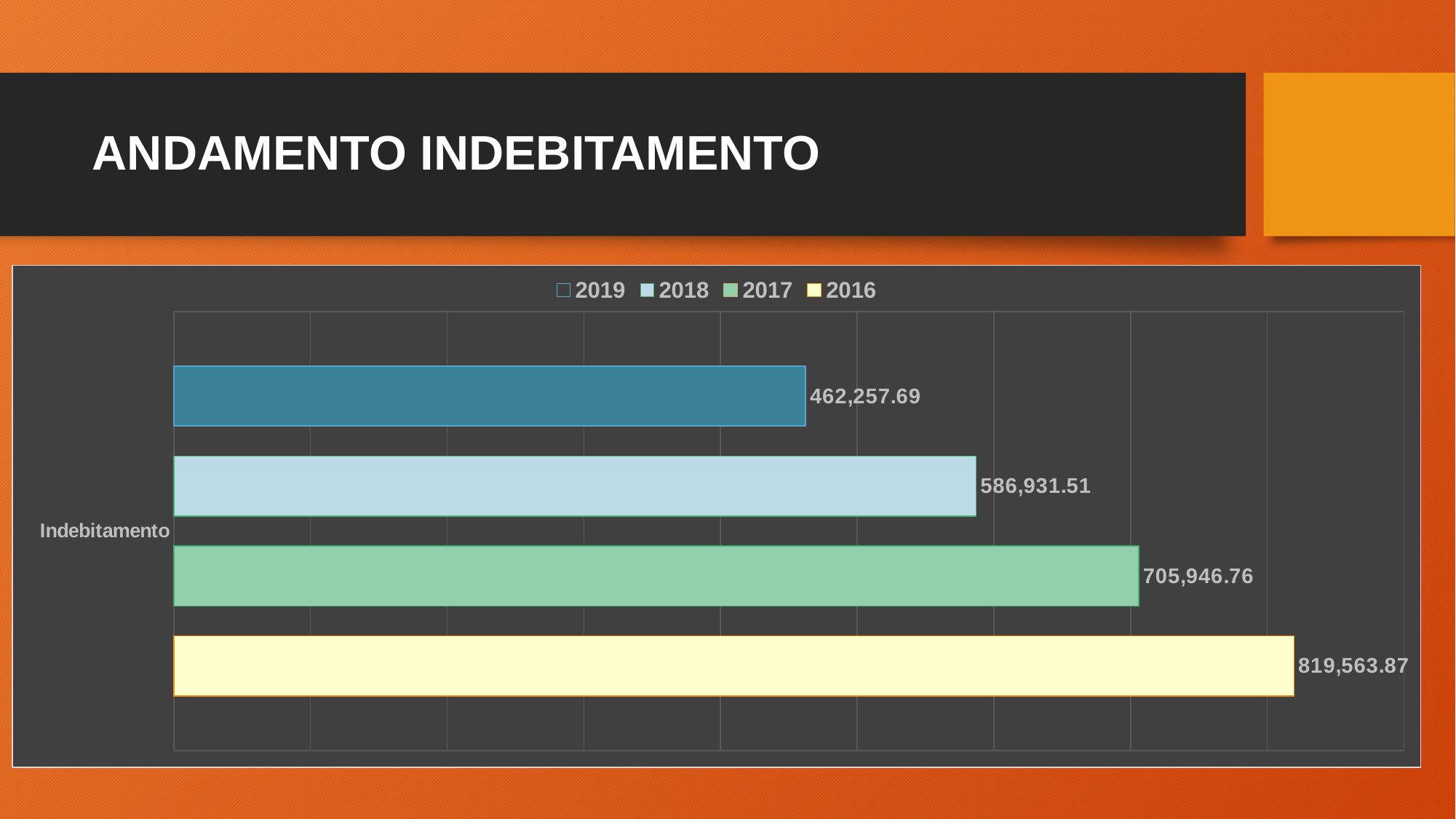
What kind of chart is shown on the slide? Bar chart Which is larger, the value for 2018 or the value for 2017? 2017 What is the value for 2016 in the Indebitamento chart? 819,563.87 What is the value for 2018 in the Indebitamento chart? 586,931.51 What is the value for 2019 in the Indebitamento chart? 462,257.69 What is the difference between the 2017 and 2018 values? 119,015.25 How many series does the legend list? 4 What is the value for 2017 in the Indebitamento chart? 705,946.76 Which year has the lowest Indebitamento value? 2019 What is the difference between the 2016 and 2019 values? 357,306.18 Does the Indebitamento value rise or fall from 2016 to 2019? Fall Which year has the highest Indebitamento value? 2016